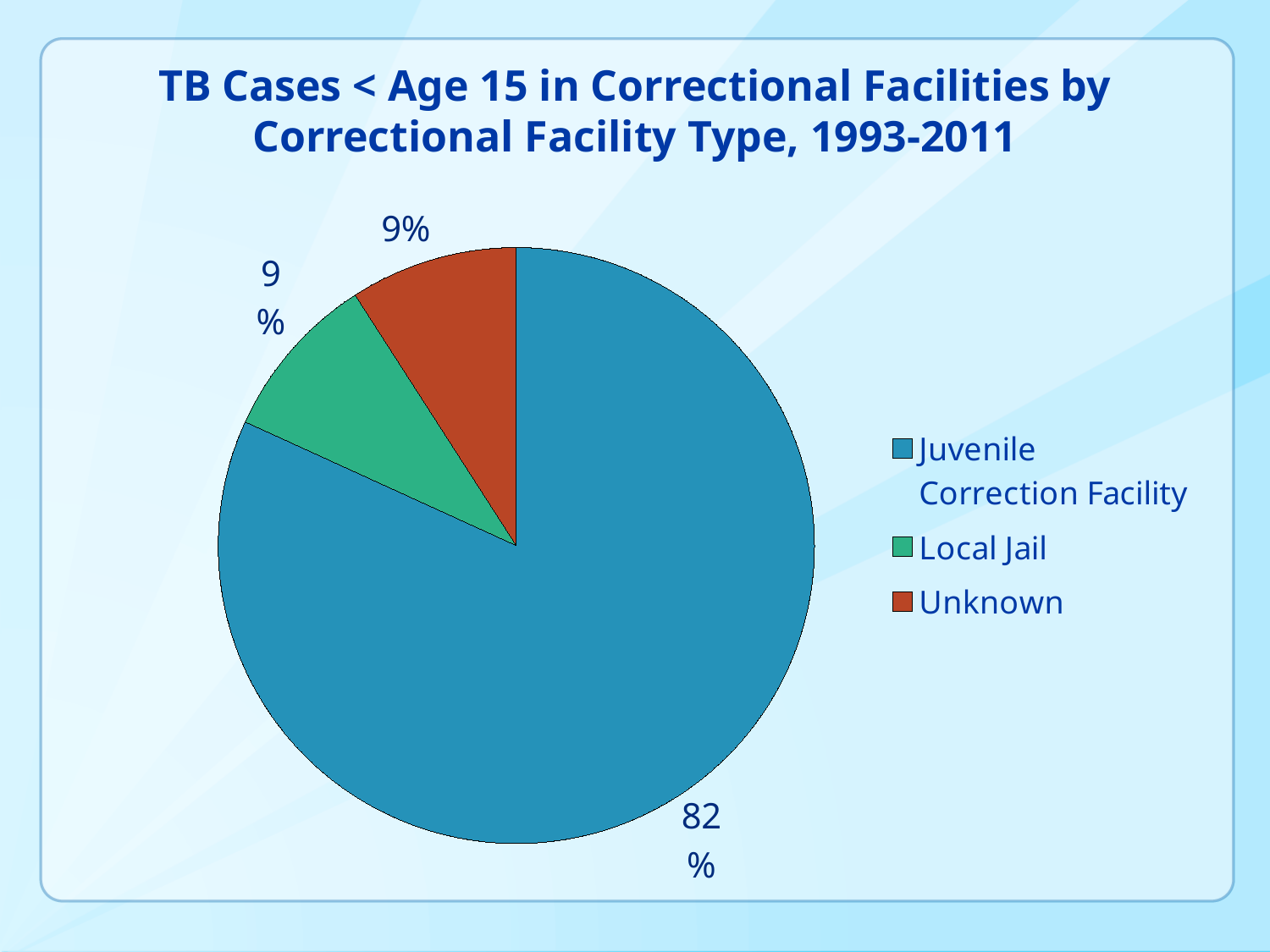
What is the combined share of Local Jail and Unknown? 18% Which correctional facility type accounts for the largest share of TB cases < age 15? Juvenile Correction Facility What is the difference in percentage points between the Juvenile Correction Facility share and the Unknown share? 73 What percentage of the pie is labelled for Local Jail? 9% Which colour represents Unknown in the pie chart? Red Which is larger, the share for Juvenile Correction Facility or the share for Local Jail? Juvenile Correction Facility How many facility types are shown in the pie chart? 3 What kind of chart is shown on the slide? Pie chart What share of TB cases < age 15 in correctional facilities were in a Juvenile Correction Facility? 82% Is the share for Juvenile Correction Facility greater or less than 50%? greater What percentage of the pie is labelled for Unknown facility type? 9% What is the title of the chart? TB Cases < Age 15 in Correctional Facilities by Correctional Facility Type, 1993-2011